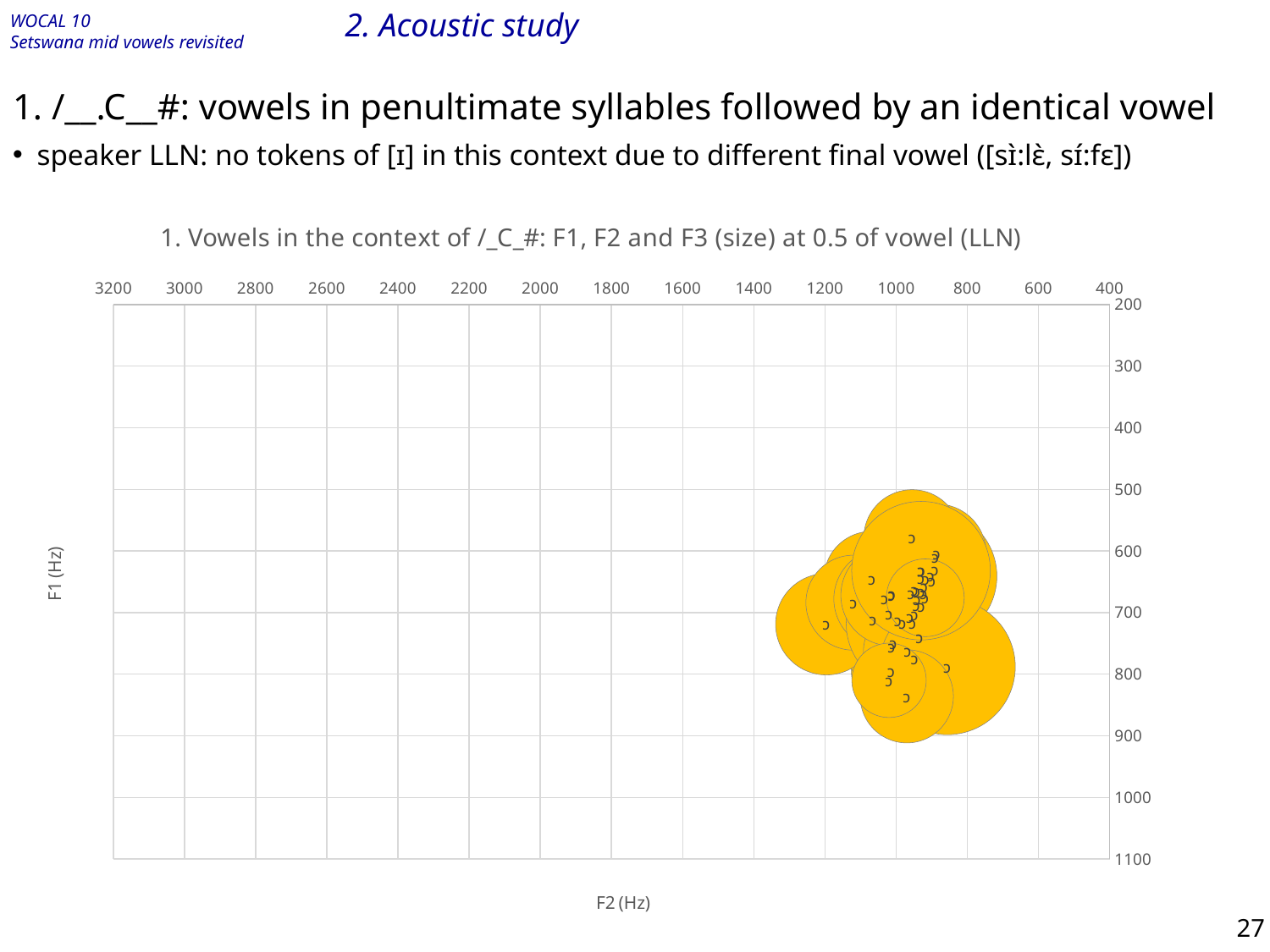
What is the smallest value shown on the vertical (F1) axis? 200 What is the lowest value shown on the horizontal (F2) axis? 400 What is the highest value shown on the horizontal (F2) axis? 3200 Are the F2 values of the plotted vowel bubbles greater or less than 1600 Hz? less What kind of chart is shown on the slide? bubble chart Which speaker's data does the chart title say is plotted? LLN What is the label of the vertical axis of the chart? F1 (Hz) Which vowel symbol is printed inside the bubbles on the chart? ɔ What is the largest value shown on the vertical (F1) axis? 1100 What is the label of the horizontal axis of the chart? F2 (Hz) Are the F1 values of the plotted vowel bubbles greater or less than 400 Hz? greater What is the title of the chart? 1. Vowels in the context of /_C_#: F1, F2 and F3 (size) at 0.5 of vowel (LLN)